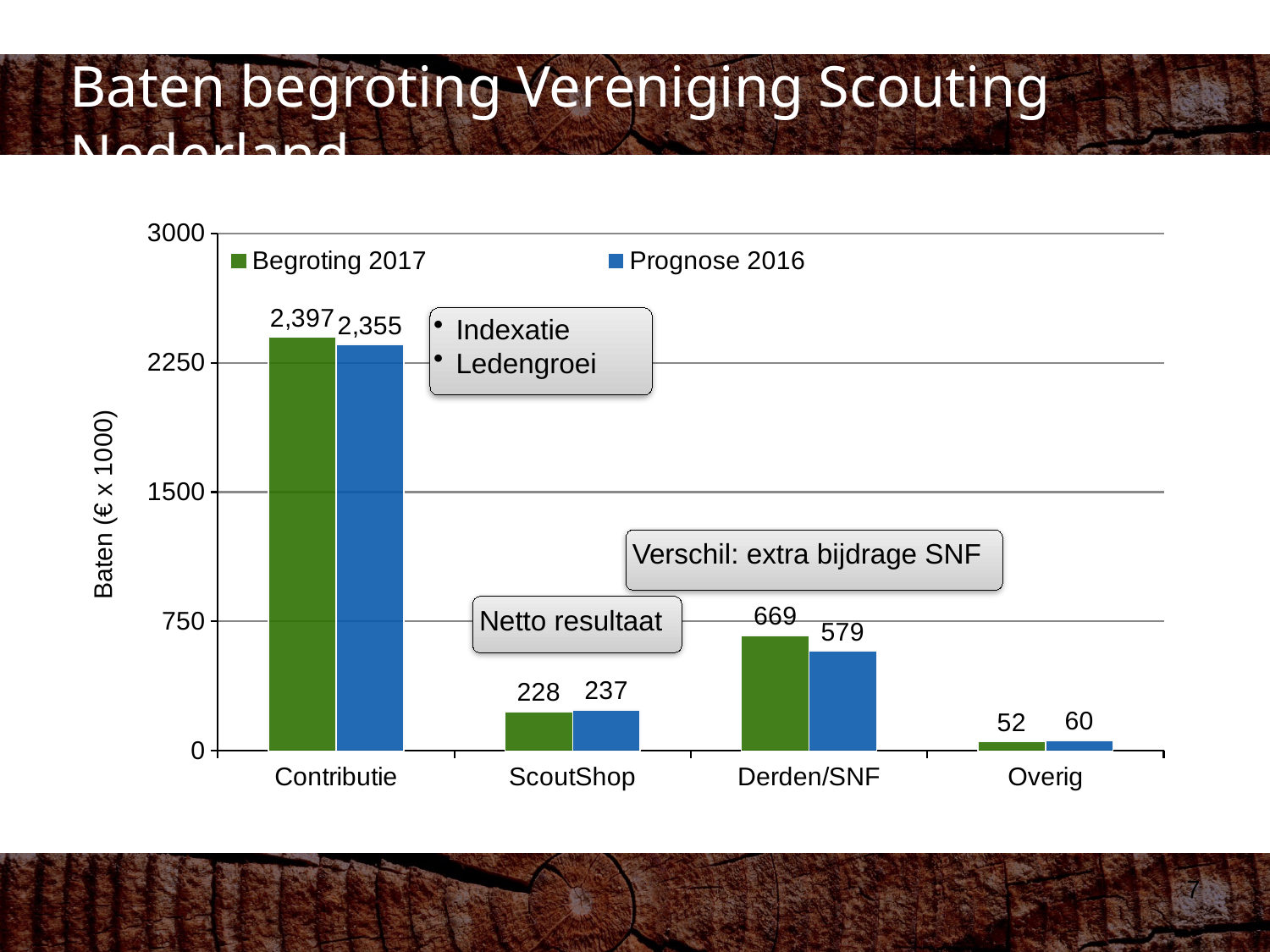
What is the Prognose 2016 value for Derden/SNF? 579 What is the Prognose 2016 value for ScoutShop? 237 What is the Begroting 2017 value for Overig? 52 How many series does the legend list? 2 What is the difference between the Begroting 2017 and Prognose 2016 values for Contributie? 42 Which category has the lowest Prognose 2016 value? Overig Which category has the highest Begroting 2017 value? Contributie What kind of chart is shown on the slide? Bar chart What is the Begroting 2017 value for Contributie? 2,397 How many categories are shown on the x axis? 4 Which is larger for ScoutShop: Begroting 2017 or Prognose 2016? Prognose 2016 What is the difference between the Begroting 2017 and Prognose 2016 values for Derden/SNF? 90